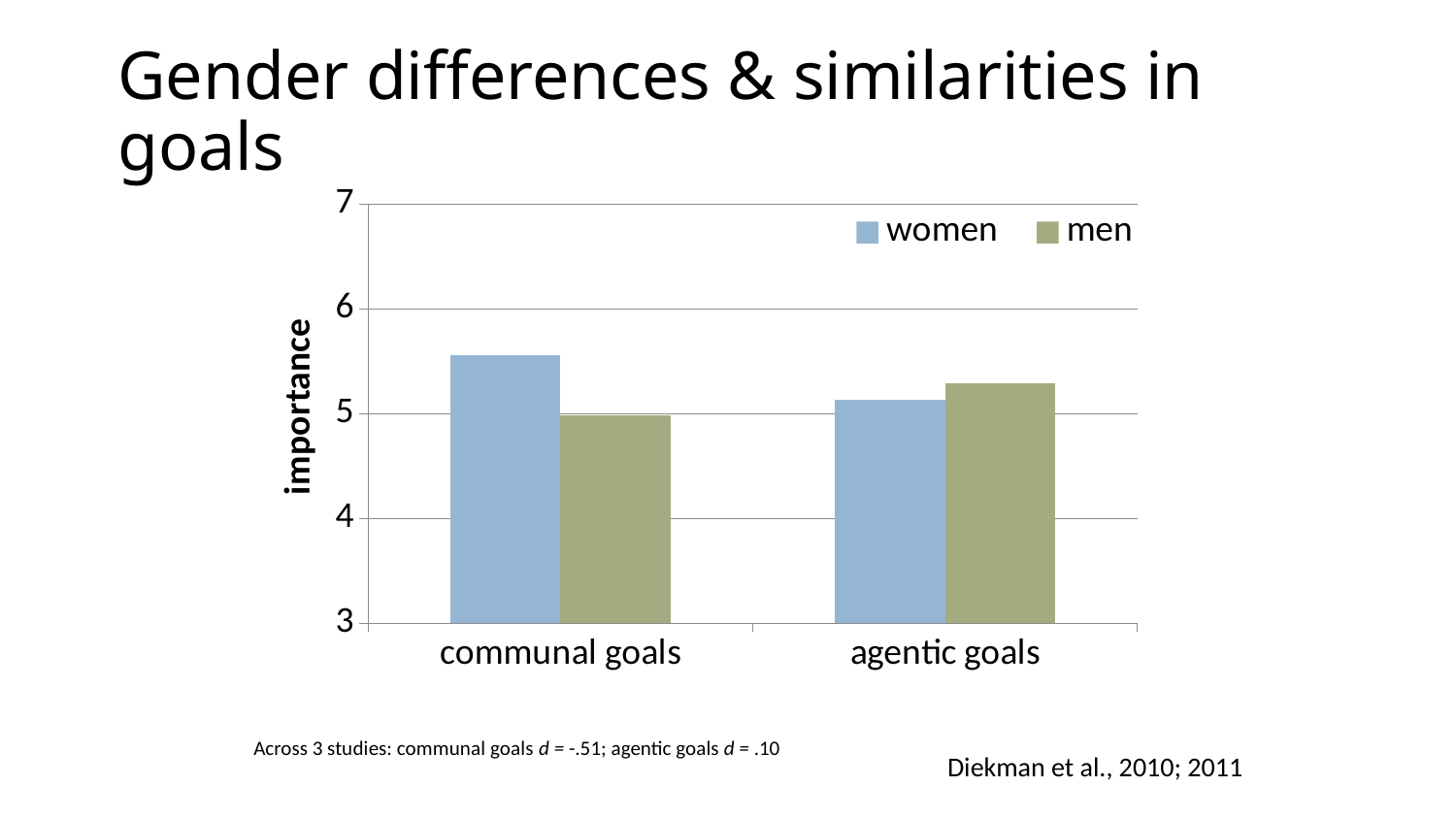
Is the value for women on communal goals greater or less than 6? less Which bar is the lowest in the chart? men, communal goals Is the value for men on agentic goals greater or less than 6? less For communal goals, which series has the larger value, women or men? women What is the label on the y axis? importance Which bar is the highest in the chart? women, communal goals How many series does the legend list? 2 How many categories are shown on the x axis? 2 What are the two series named in the legend? women and men For agentic goals, which series has the larger value, women or men? men What kind of chart is shown on the slide? bar chart Is the value for women on communal goals greater or less than 5? greater